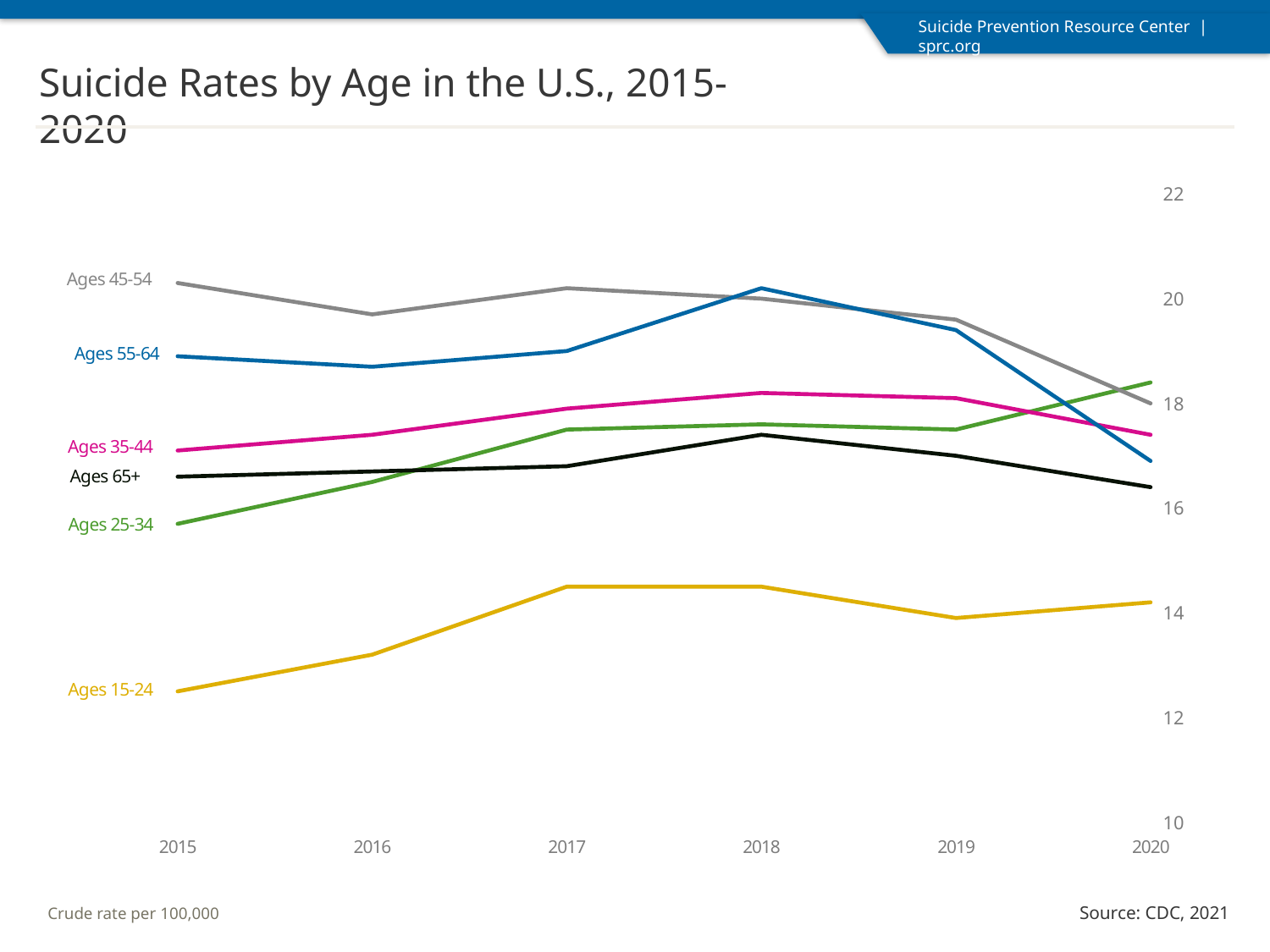
Which age group has the highest suicide rate in 2015? Ages 45-54 How many age-group series are plotted on the chart? 6 What is the title of the chart? Suicide Rates by Age in the U.S., 2015-2020 In 2020, which is larger: the value for Ages 35-44 or the value for Ages 65+? Ages 35-44 What kind of chart is shown on the slide? Line chart Is the value for Ages 15-24 in 2015 greater or less than 14? less Which age group has the lowest suicide rate in 2020? Ages 15-24 Which age group has the highest suicide rate in 2020? Ages 25-34 Does the line for Ages 25-34 rise or fall overall from 2015 to 2020? Rise Is the value for Ages 55-64 in 2020 greater or less than 18? less How many years are shown along the x axis? 6 Is the value for Ages 15-24 in 2017 greater or less than 14? greater